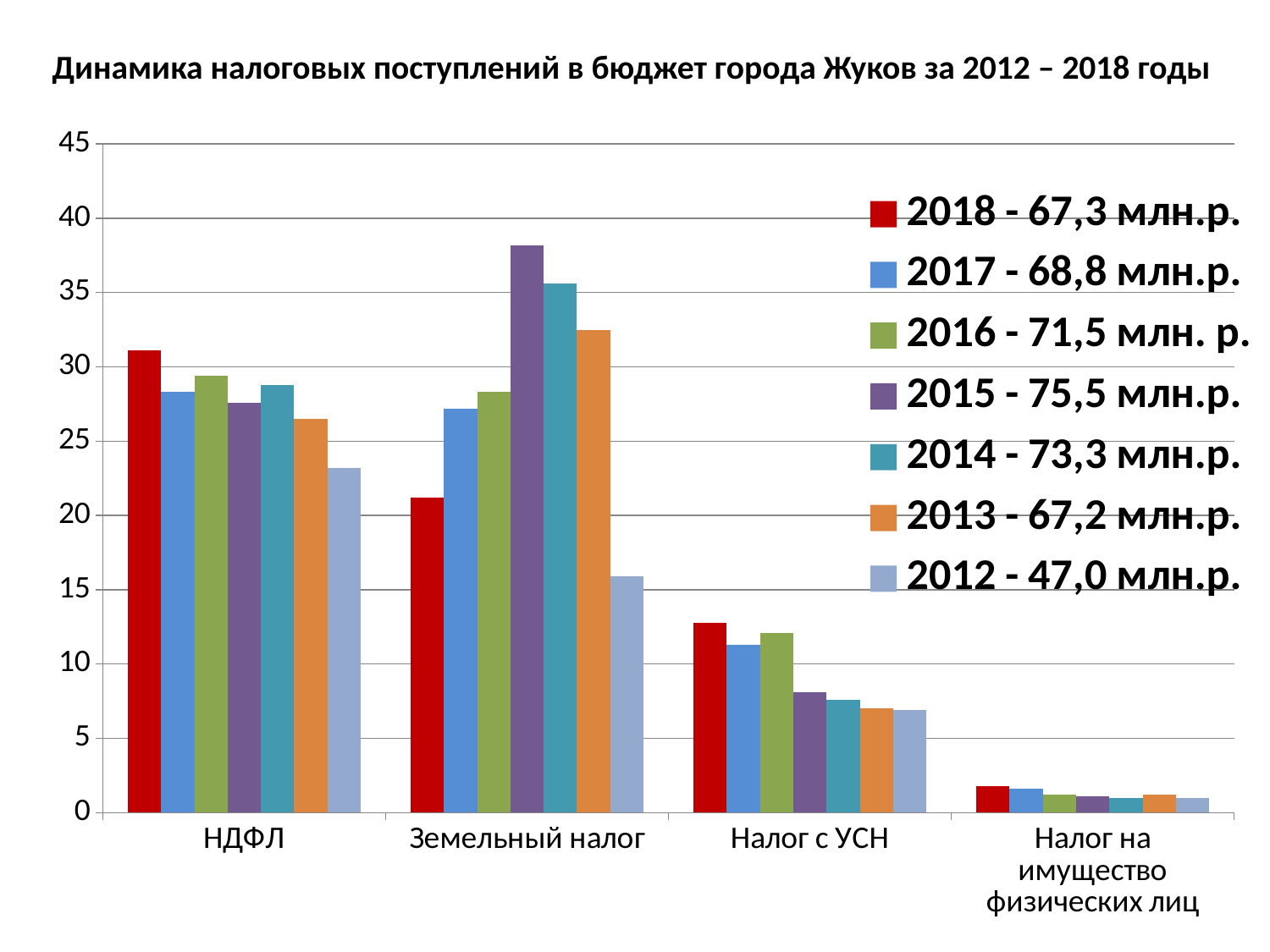
Is the 2018 value for НДФЛ greater or less than 25? greater For Налог с УСН, which is larger: the 2018 bar or the 2012 bar? 2018 How many series does the legend list? 7 For Земельный налог, which is larger: the 2014 bar or the 2013 bar? 2014 What is the legend entry for the 2015 series? 2015 - 75,5 млн.р. For Земельный налог, which year has the lowest bar? 2012 Is the 2018 value for Земельный налог greater or less than 25? less For Земельный налог, which year has the highest bar? 2015 Is the 2018 value for Налог на имущество физических лиц greater or less than 5? less How many tax categories are shown on the x axis? 4 For НДФЛ, which year has the highest bar? 2018 What kind of chart is shown on the slide? Bar chart